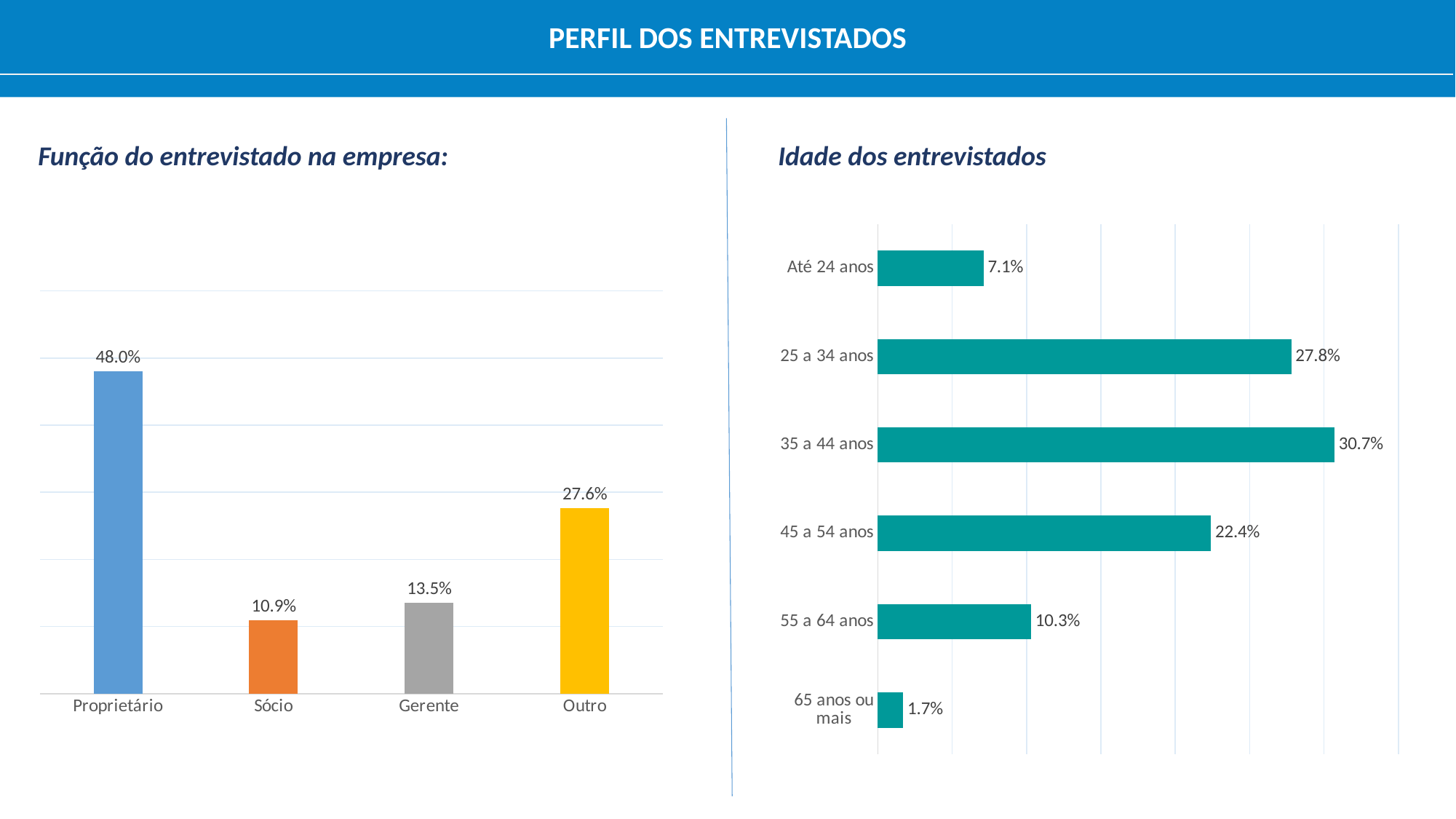
In the 'Idade dos entrevistados' chart, which is larger: 25 a 34 anos or 45 a 54 anos? 25 a 34 anos In the 'Idade dos entrevistados' chart, which age group has the highest value? 35 a 44 anos In the 'Função do entrevistado na empresa' chart, what is the difference between Outro and Gerente? 14.1% In the 'Função do entrevistado na empresa' chart, what colour is the bar for Outro? Yellow In the 'Idade dos entrevistados' chart, which age group has the lowest value? 65 anos ou mais In the 'Idade dos entrevistados' chart, what is the difference between 35 a 44 anos and 25 a 34 anos? 2.9% In the 'Função do entrevistado na empresa' chart, what kind of chart is it? Bar chart In the 'Idade dos entrevistados' chart, how many age groups are shown? 6 In the 'Função do entrevistado na empresa' chart, how many categories are shown? 4 In the 'Função do entrevistado na empresa' chart, what is the value for Proprietário? 48.0% In the 'Idade dos entrevistados' chart, what is the value for 45 a 54 anos? 22.4% In the 'Função do entrevistado na empresa' chart, which category has the lowest value? Sócio